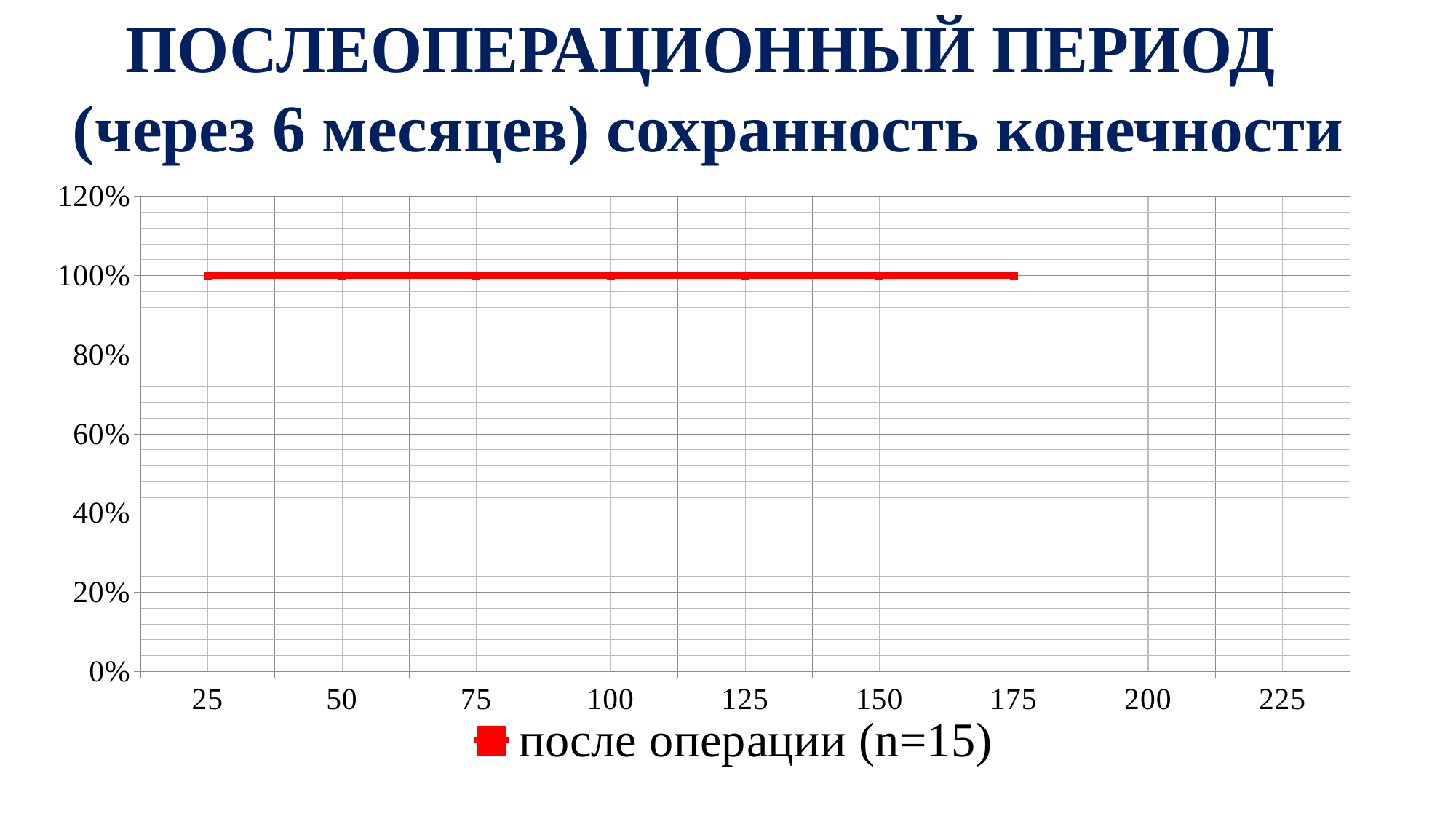
Do the values rise, fall, or stay flat along the x axis? stay flat How many series does the legend list? 1 What is the name of the series shown in the legend? после операции (n=15) What is the difference between the value at x = 50 and the value at x = 125? 0% What colour is the plotted line? red What is the value of the series at x = 100? 100% How many data points are plotted on the line? 7 What kind of chart is shown on the slide? line chart What is the highest value shown on the vertical axis? 120% Is the value at x = 150 greater or less than 80%? greater What is the value of the series at x = 175? 100% What is the value of the series at x = 25? 100%